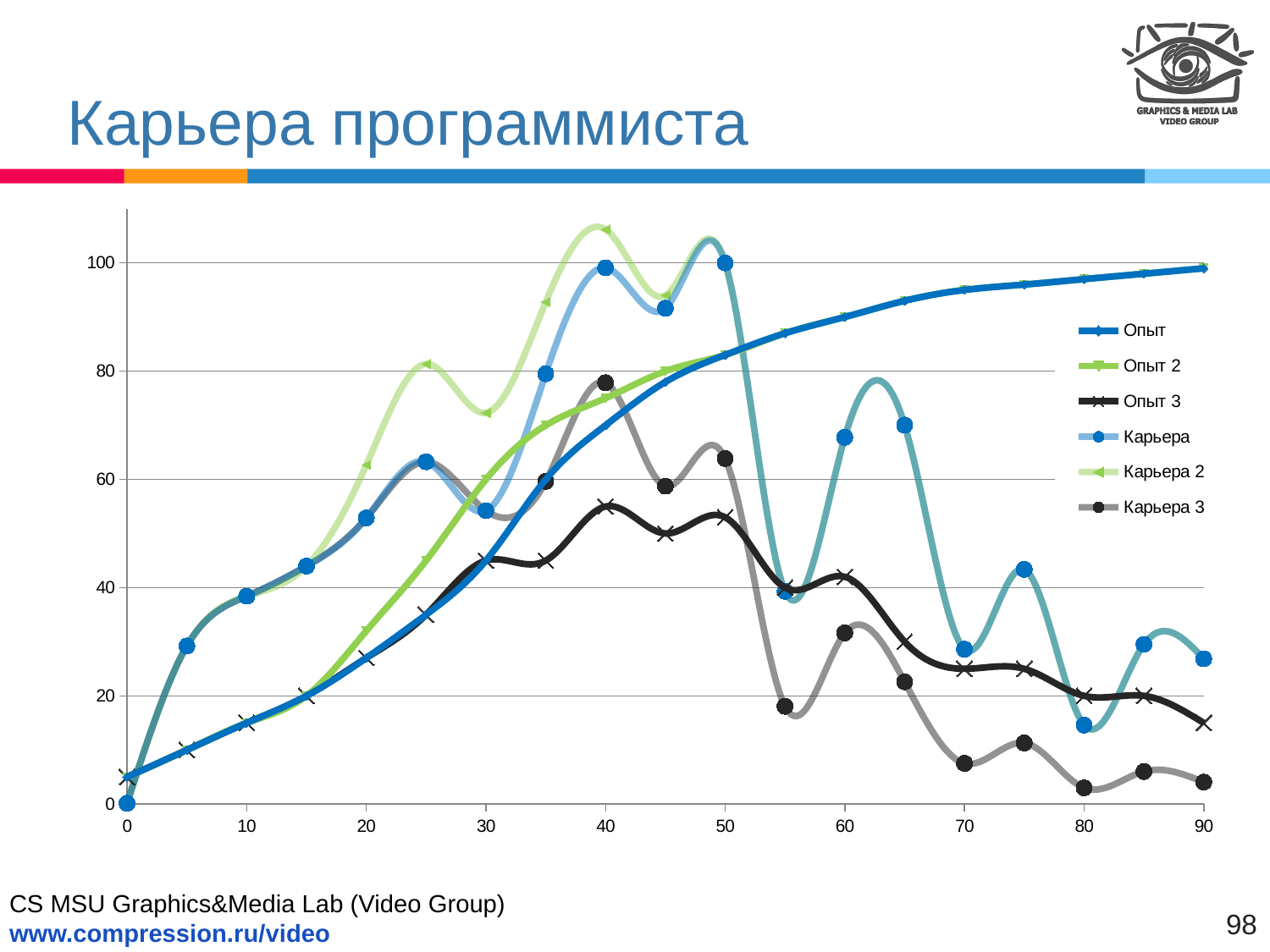
Is the value of the Карьера 2 series at x = 40 greater or less than 100? greater Which series are listed in the legend? Опыт, Опыт 2, Опыт 3, Карьера, Карьера 2, Карьера 3 Which series has the lowest value at x = 90? Карьера 3 At x = 60, which series has the larger value, Карьера or Карьера 3? Карьера At x = 90, which series has the larger value, Опыт or Опыт 3? Опыт Is the value of the Карьера series at x = 40 greater or less than 80? greater How many series does the legend list? 6 What kind of chart is shown on the slide? line chart Is the value of the Карьера 3 series at x = 70 greater or less than 20? less Does the Опыт series rise or fall as x increases from 0 to 90? rises